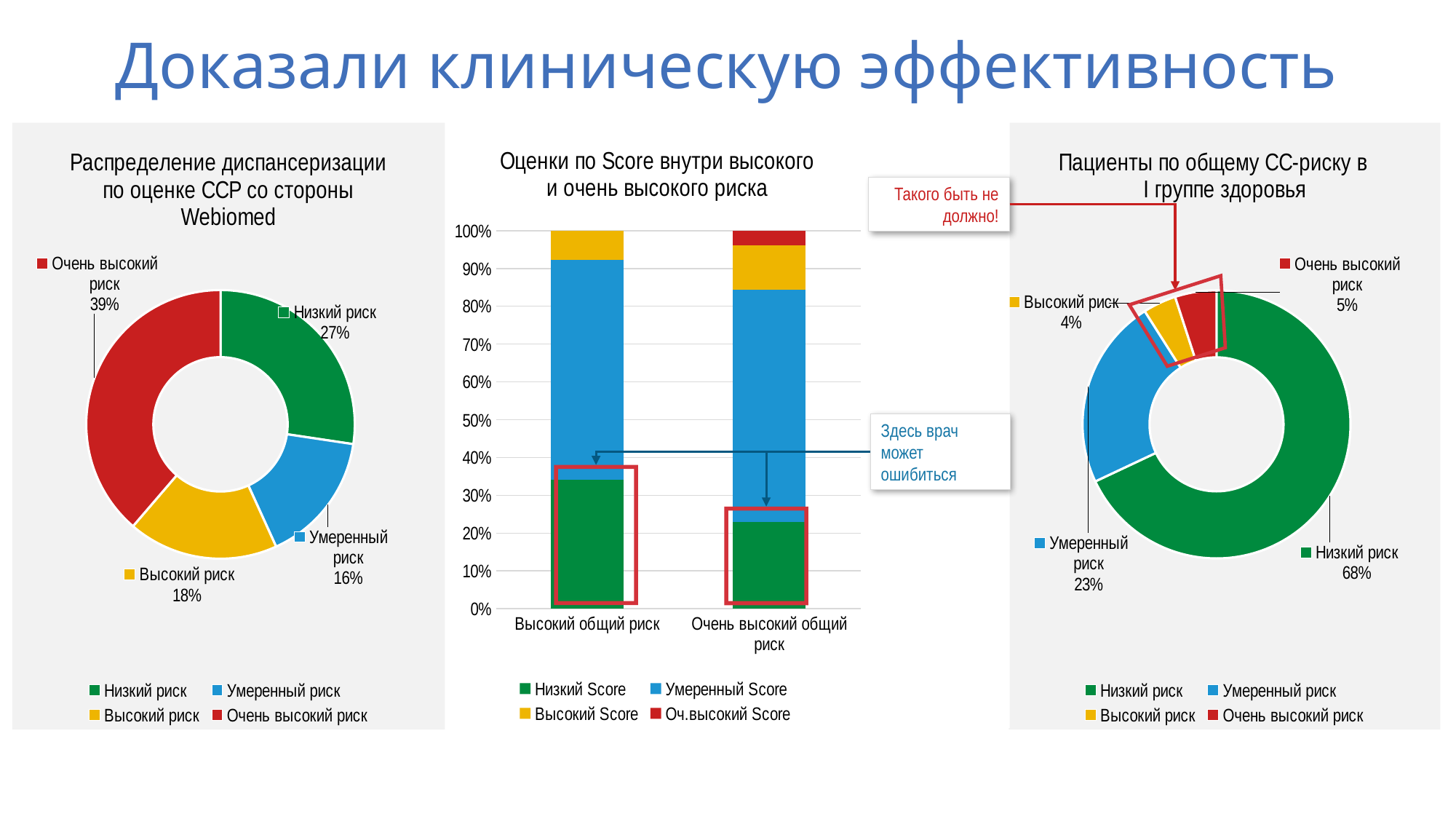
What kind of chart is the middle chart 'Оценки по Score внутри высокого и очень высокого риска'? Stacked bar chart In the right chart 'Пациенты по общему СС-риску в I группе здоровья', which is larger: 'Умеренный риск' or 'Очень высокий риск'? Умеренный риск In the left chart 'Распределение диспансеризации по оценке ССР со стороны Webiomed', what is the difference between the shares of 'Низкий риск' and 'Высокий риск'? 9% In the left chart 'Распределение диспансеризации по оценке ССР со стороны Webiomed', which category has the largest share? Очень высокий риск In the middle chart 'Оценки по Score внутри высокого и очень высокого риска', how many categories are shown on the x axis? 2 How many series does the legend of the middle chart 'Оценки по Score внутри высокого и очень высокого риска' list? 4 In the right chart 'Пациенты по общему СС-риску в I группе здоровья', which category has the smallest share? Высокий риск In the middle chart 'Оценки по Score внутри высокого и очень высокого риска', is the 'Низкий Score' value for 'Высокий общий риск' greater or less than 30%? greater In the left chart 'Распределение диспансеризации по оценке ССР со стороны Webiomed', what share is labelled for 'Умеренный риск'? 16% In the right chart 'Пациенты по общему СС-риску в I группе здоровья', what share is labelled for 'Низкий риск'? 68% In the right chart 'Пациенты по общему СС-риску в I группе здоровья', what is the combined share of 'Высокий риск' and 'Очень высокий риск'? 9% In the left chart 'Распределение диспансеризации по оценке ССР со стороны Webiomed', what share is labelled for 'Очень высокий риск'? 39%